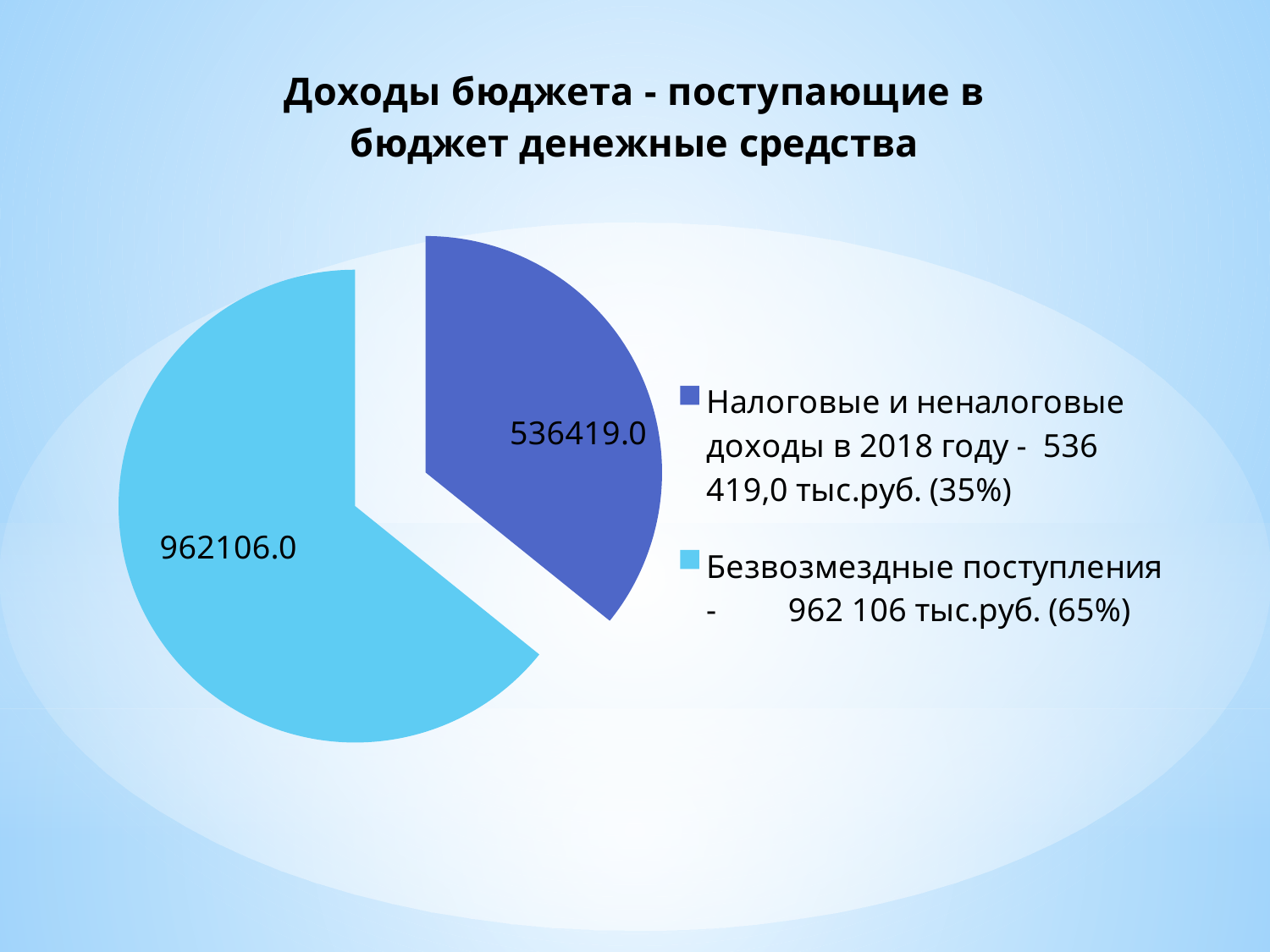
Which is larger: the value for "Налоговые и неналоговые доходы в 2018 году" or the value for "Безвозмездные поступления"? Безвозмездные поступления What is the value of the slice for "Налоговые и неналоговые доходы в 2018 году"? 536419.0 What is the value of the slice for "Безвозмездные поступления"? 962106.0 Which category has the smallest slice of the pie? Налоговые и неналоговые доходы в 2018 году Which category has the largest slice of the pie? Безвозмездные поступления What is the title of the chart on the slide? Доходы бюджета - поступающие в бюджет денежные средства How many slices does the pie chart have? 2 What type of chart is shown on the slide? pie chart What share of the pie does "Безвозмездные поступления" represent, according to the legend? 65% How many entries does the legend list? 2 What share of the pie does "Налоговые и неналоговые доходы в 2018 году" represent, according to the legend? 35% What is the difference between the values for "Безвозмездные поступления" and "Налоговые и неналоговые доходы в 2018 году"? 425687.0